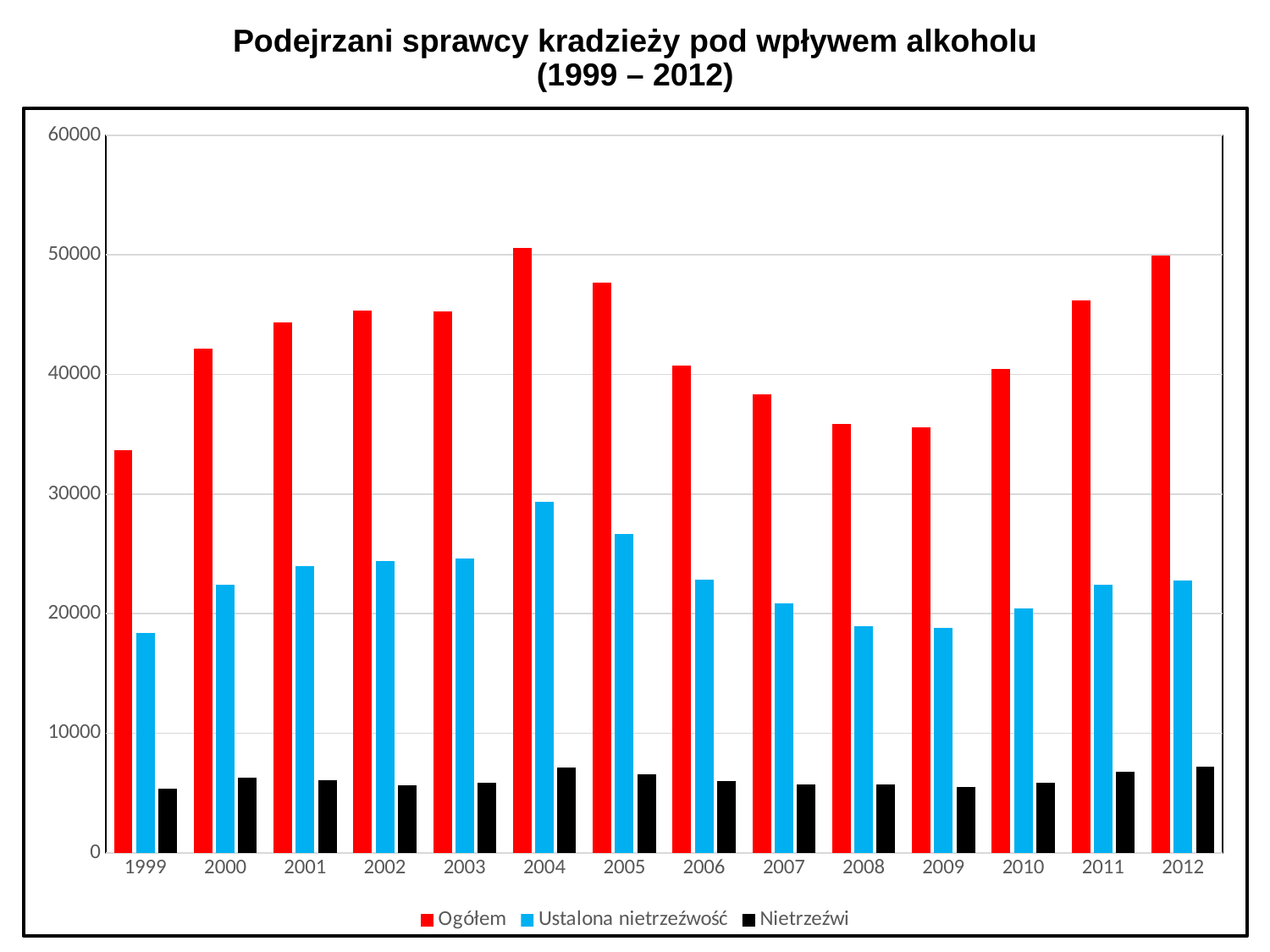
How many years are shown on the x axis? 14 How many series does the legend list? 3 Is the Ogółem value for 2009 greater or less than 40000? less Is the Nietrzeźwi value for 2012 greater or less than 10000? less Is the Ustalona nietrzeźwość value for 2004 greater or less than 30000? less What kind of chart is shown on the slide? bar chart In which year is the Ogółem value highest? 2004 In which year is the Ogółem value lowest? 1999 In which year is the Ustalona nietrzeźwość value highest? 2004 Which is larger, the Ustalona nietrzeźwość value for 2005 or for 2006? 2005 Which series is shown in red in the legend? Ogółem